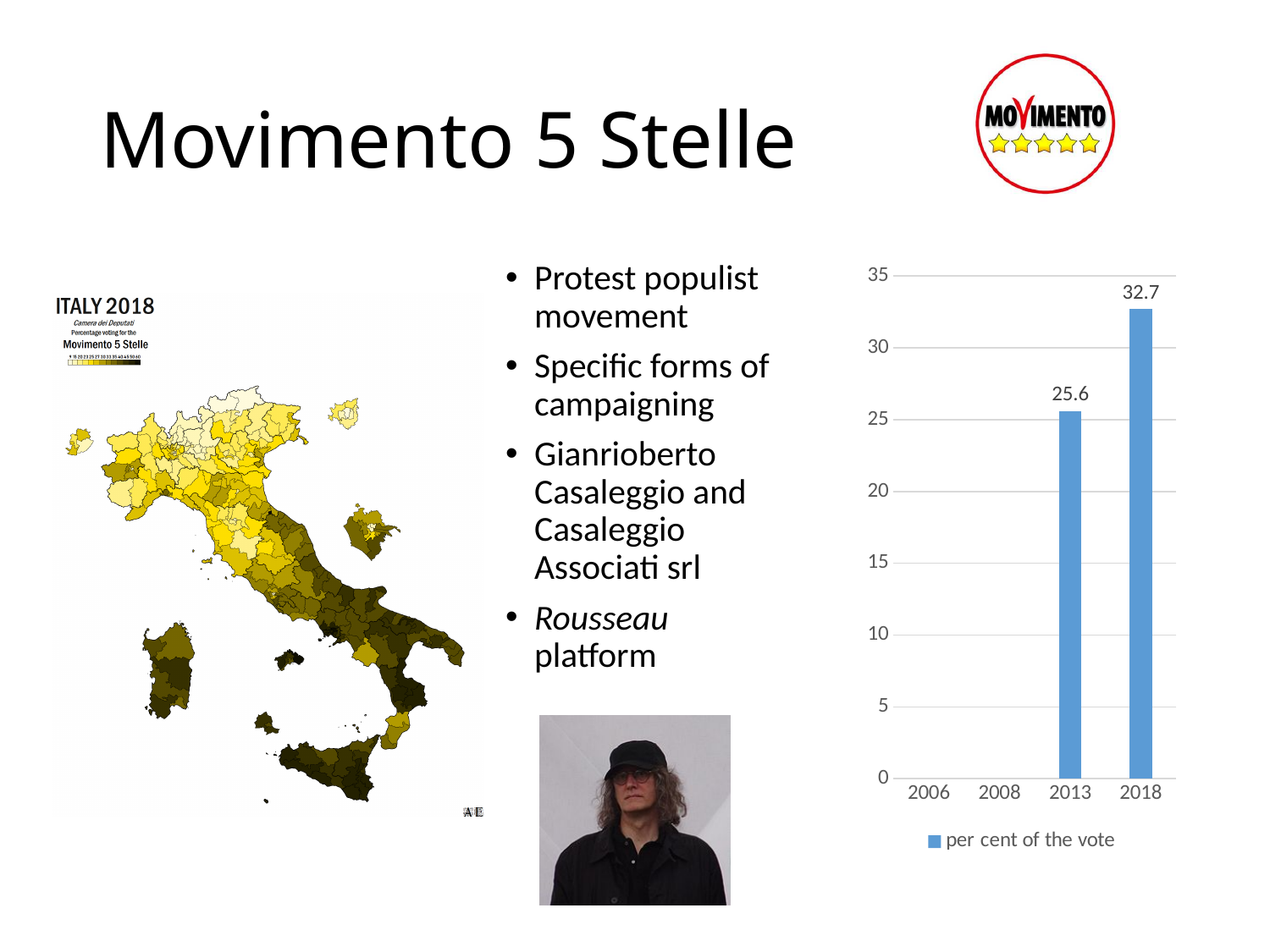
What is the legend entry of the bar chart? per cent of the vote Which year has the highest per cent of the vote in the bar chart? 2018 Is the value for 2018 in the bar chart greater or less than 30? greater What kind of chart is shown on the right of the slide? bar chart How many series does the legend of the bar chart list? 1 What is the per cent of the vote for 2013 in the bar chart? 25.6 Do the values in the bar chart rise or fall from 2013 to 2018? rise Is the value for 2013 in the bar chart greater or less than 30? less How many years are shown on the x axis of the bar chart? 4 What is the difference between the 2018 and 2013 values in the bar chart? 7.1 What is the per cent of the vote for 2018 in the bar chart? 32.7 Which is larger in the bar chart, the value for 2013 or the value for 2018? 2018